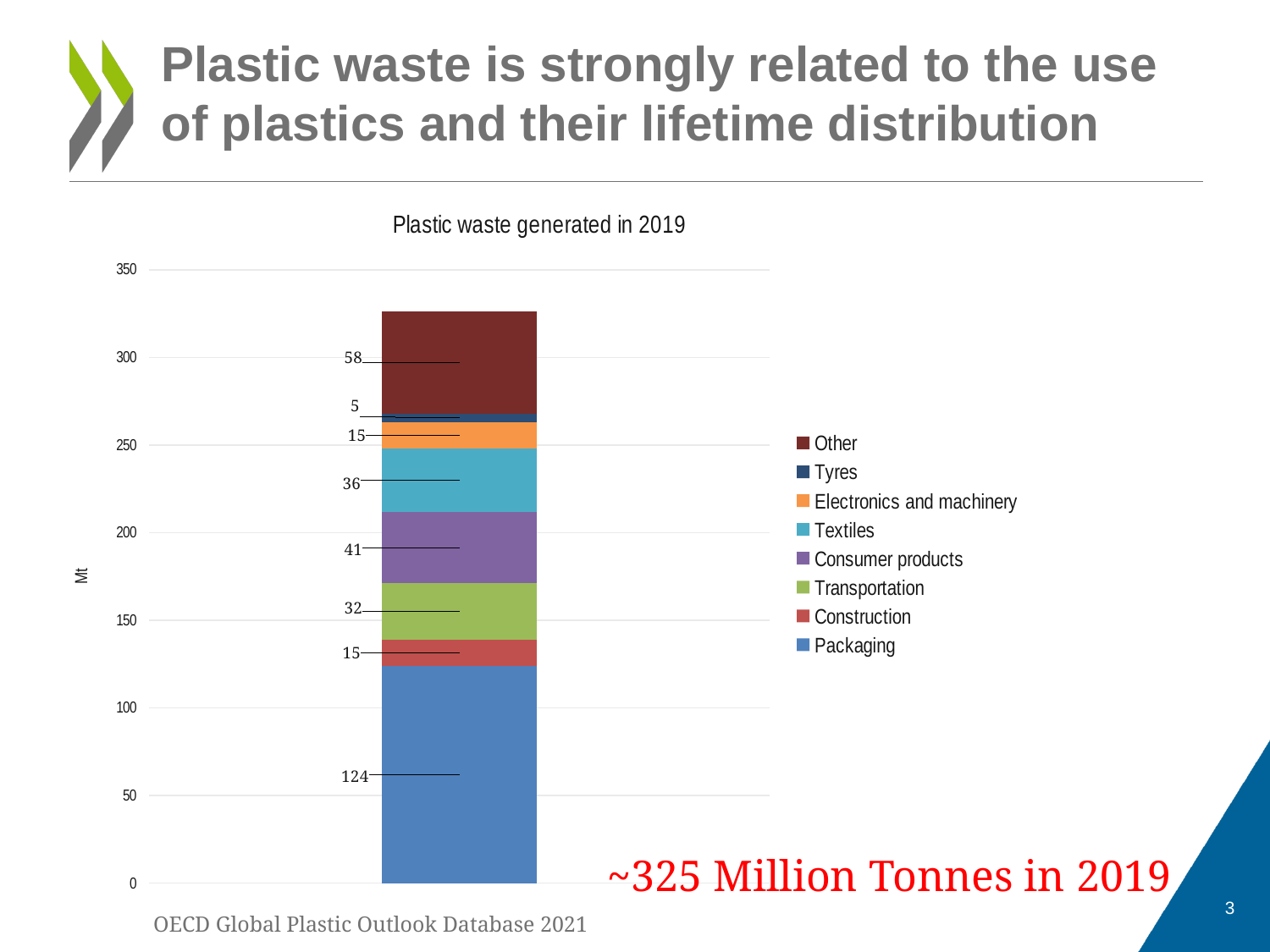
Which series has the largest segment in the stacked bar? Packaging Which is larger, the value for Transportation or the value for Consumer products? Consumer products Which series has the smallest segment in the stacked bar? Tyres What is the value for Packaging in the stacked bar? 124 What is the difference between the values for Other and Textiles? 22 What is the value for Tyres? 5 What is the value for Textiles? 36 Is the top of the stacked bar greater or less than 300? greater How many series does the legend list? 8 What is the value for Other in the stacked bar? 58 What is the value for Consumer products? 41 What kind of chart is shown on the slide? Stacked bar chart